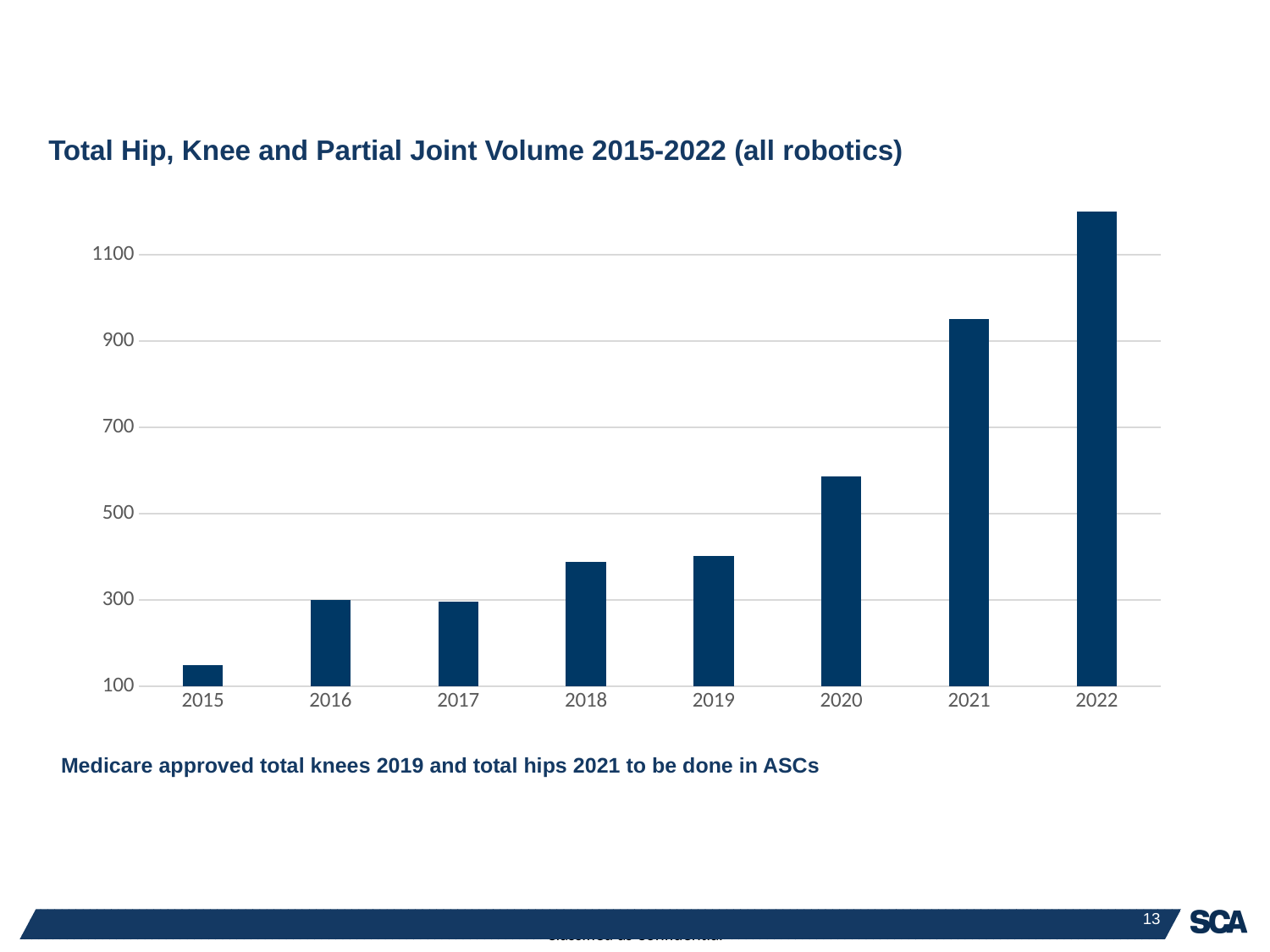
Which year has the lowest volume in the chart? 2015 Is the value for 2022 greater or less than 1100? greater Which year has the larger volume, 2020 or 2021? 2021 Is the value for 2020 greater or less than 500? greater What is the title of the chart? Total Hip, Knee and Partial Joint Volume 2015-2022 (all robotics) Do the volumes generally rise or fall from 2015 to 2022? Rise How many years are shown on the x axis of the chart? 8 What kind of chart is shown on the slide? Bar chart Is the value for 2021 greater or less than 900? greater Which year has the highest volume in the chart? 2022